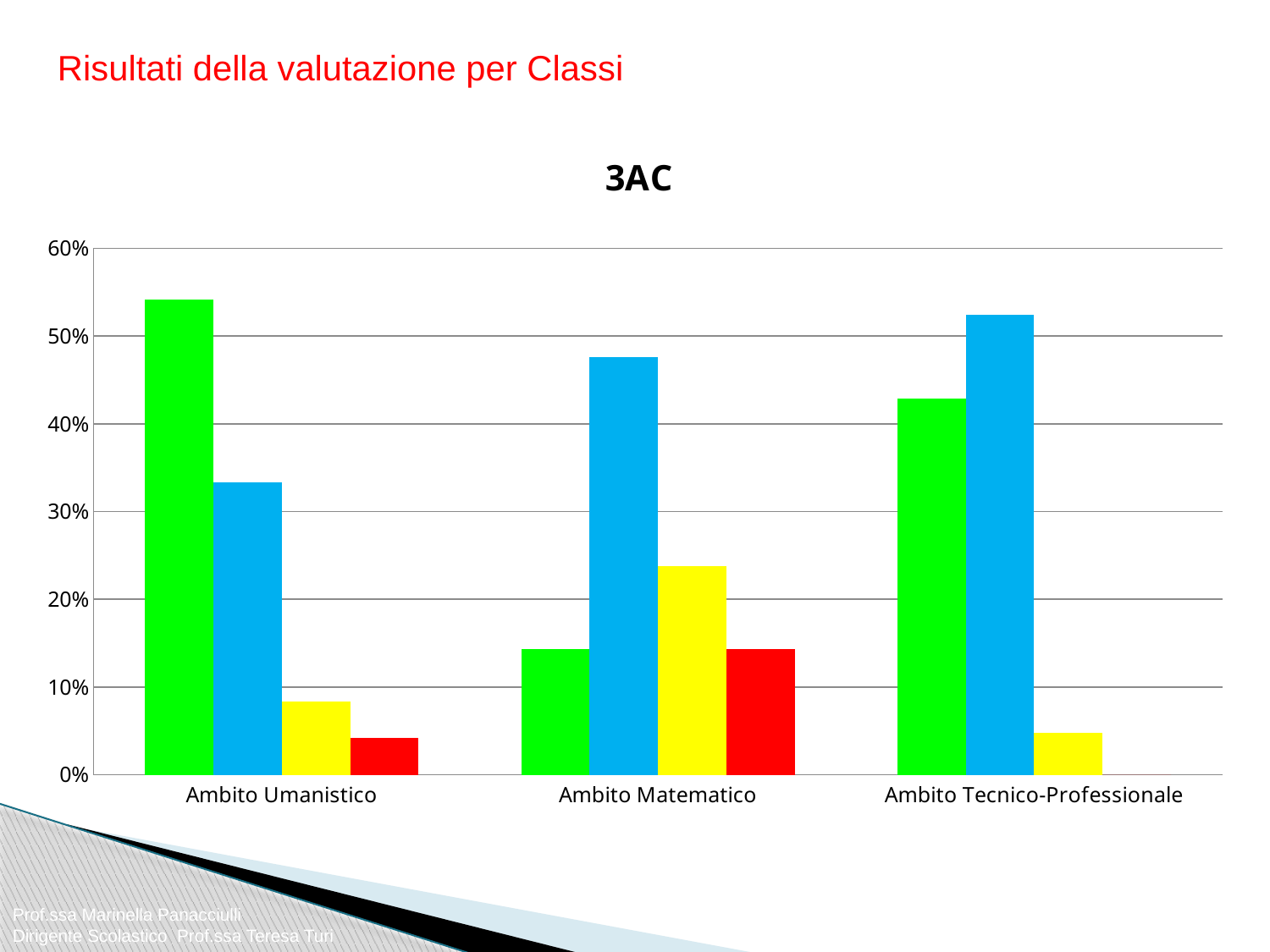
What is the title of the chart? 3AC Is the value of the green bar for Ambito Umanistico greater or less than 50%? greater In which category is the green bar the tallest? Ambito Umanistico How many categories are shown on the x axis of the chart? 3 Is the value of the yellow bar for Ambito Tecnico-Professionale greater or less than 10%? less Is the value of the blue bar for Ambito Matematico greater or less than 40%? greater What type of chart is shown on the slide? bar chart Which coloured bar is the tallest within Ambito Matematico? blue How many bars are plotted for Ambito Tecnico-Professionale? 3 Which is larger: the green bar for Ambito Umanistico or the green bar for Ambito Tecnico-Professionale? Ambito Umanistico